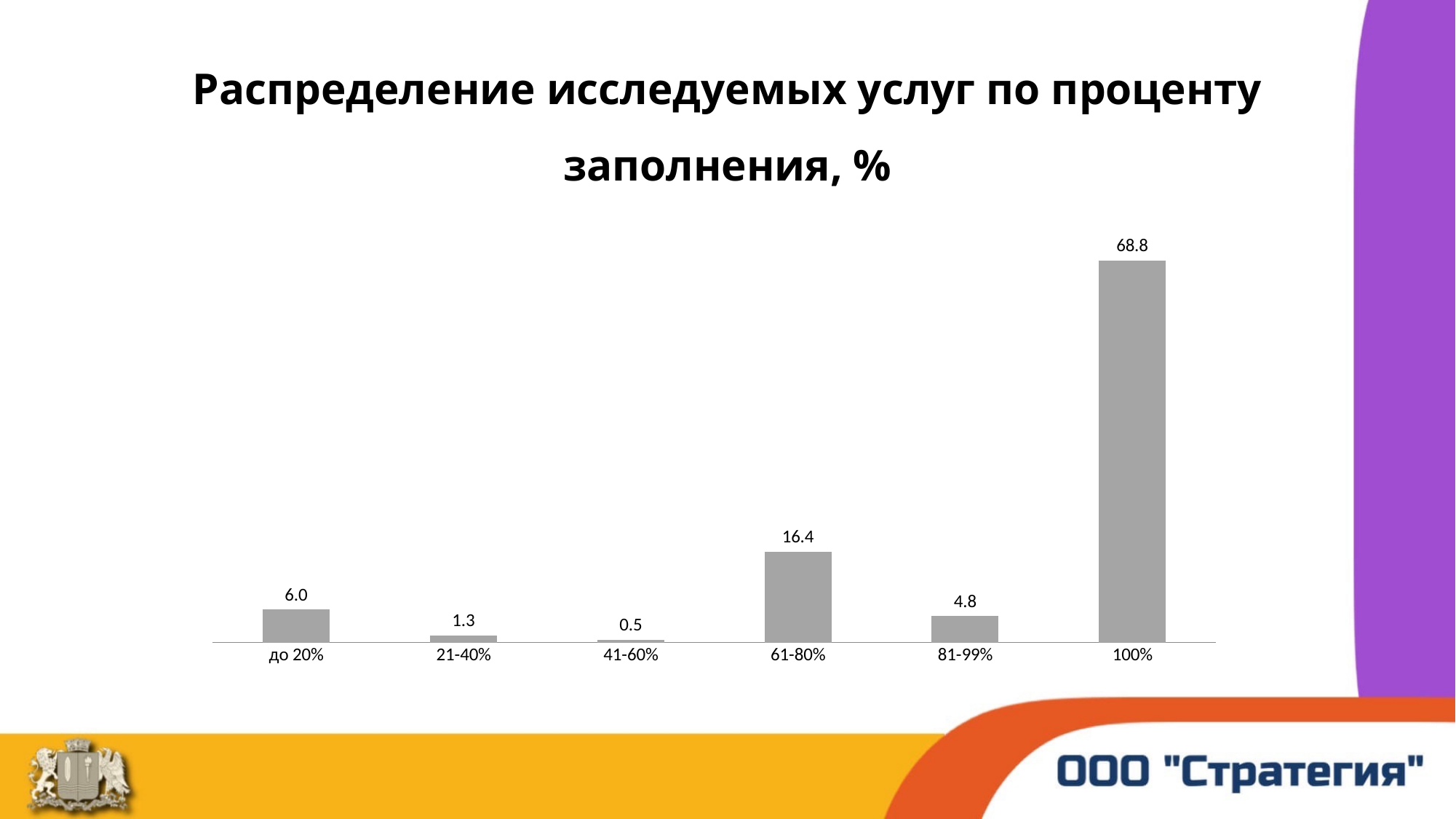
What is the difference between the values for "100%" and "61-80%"? 52.4 Which category has the highest value? 100% Which category has the lowest value? 41-60% What is the difference between the values for "до 20%" and "81-99%"? 1.2 What is the title of the chart? Распределение исследуемых услуг по проценту заполнения, % What is the value for the "100%" category? 68.8 How many categories are shown on the x axis? 6 What is the value for the "81-99%" category? 4.8 Which is larger, the value for "21-40%" or the value for "41-60%"? 21-40% What is the value for the "61-80%" category? 16.4 What is the value for the "до 20%" category? 6.0 What kind of chart is shown on the slide? Bar chart